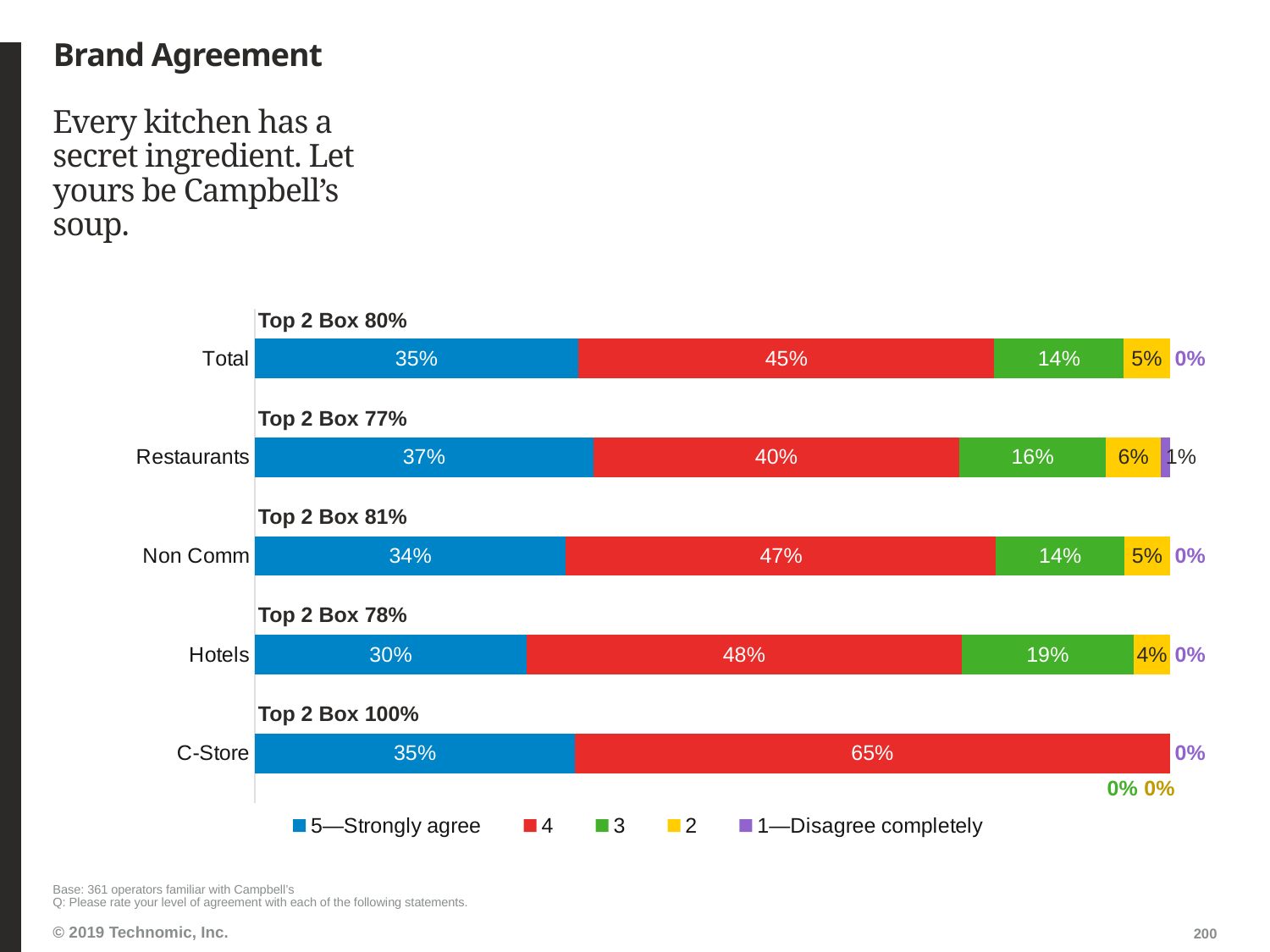
What kind of chart is shown on the slide? Stacked bar chart What is the Top 2 Box value shown for C-Store? 100% What percentage of Hotels respondents selected "5—Strongly agree"? 30% Which is larger: the "3" value for Hotels or the "3" value for Restaurants? Hotels Which category has the highest value for the "4" series? C-Store What is the difference between the "4" value for Hotels and the "4" value for Restaurants? 8% How many categories are shown on the chart? 5 How many series does the legend list? 5 Which category has the lowest value for "5—Strongly agree"? Hotels What percentage of Restaurants respondents selected "4"? 40% Which legend entry is shown in red? 4 What percentage of Non Comm respondents selected "3"? 14%